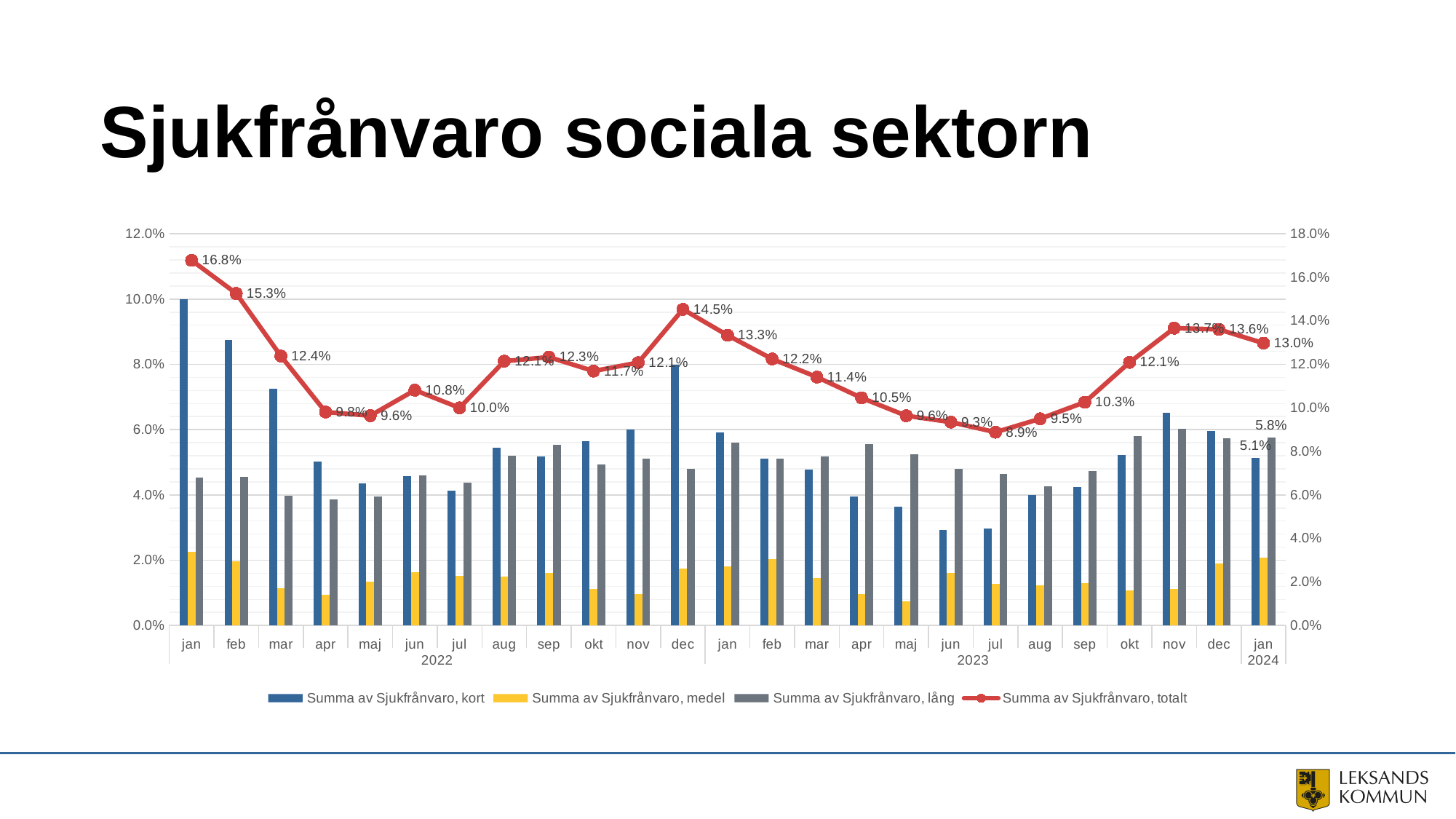
What is the value of Summa av Sjukfrånvaro, totalt for jul 2023? 8.9% How many series does the legend list? 4 What is the value of Summa av Sjukfrånvaro, totalt for jan 2022? 16.8% What kind of chart is shown on the slide? Combined bar and line chart In which month is Summa av Sjukfrånvaro, totalt highest? jan 2022 Is the value of Summa av Sjukfrånvaro, kort for jan 2022 greater or less than 8.0% on the left axis? greater How many months are shown on the x axis? 25 In which month is Summa av Sjukfrånvaro, totalt lowest? jul 2023 What is the difference between the totalt values for jan 2022 and feb 2022? 1.5 percentage points Does Summa av Sjukfrånvaro, totalt rise or fall from jan 2022 to maj 2022? fall Which has a higher totalt value, dec 2022 or jan 2023? dec 2022 What is the value of Summa av Sjukfrånvaro, kort for jan 2024? 5.1%